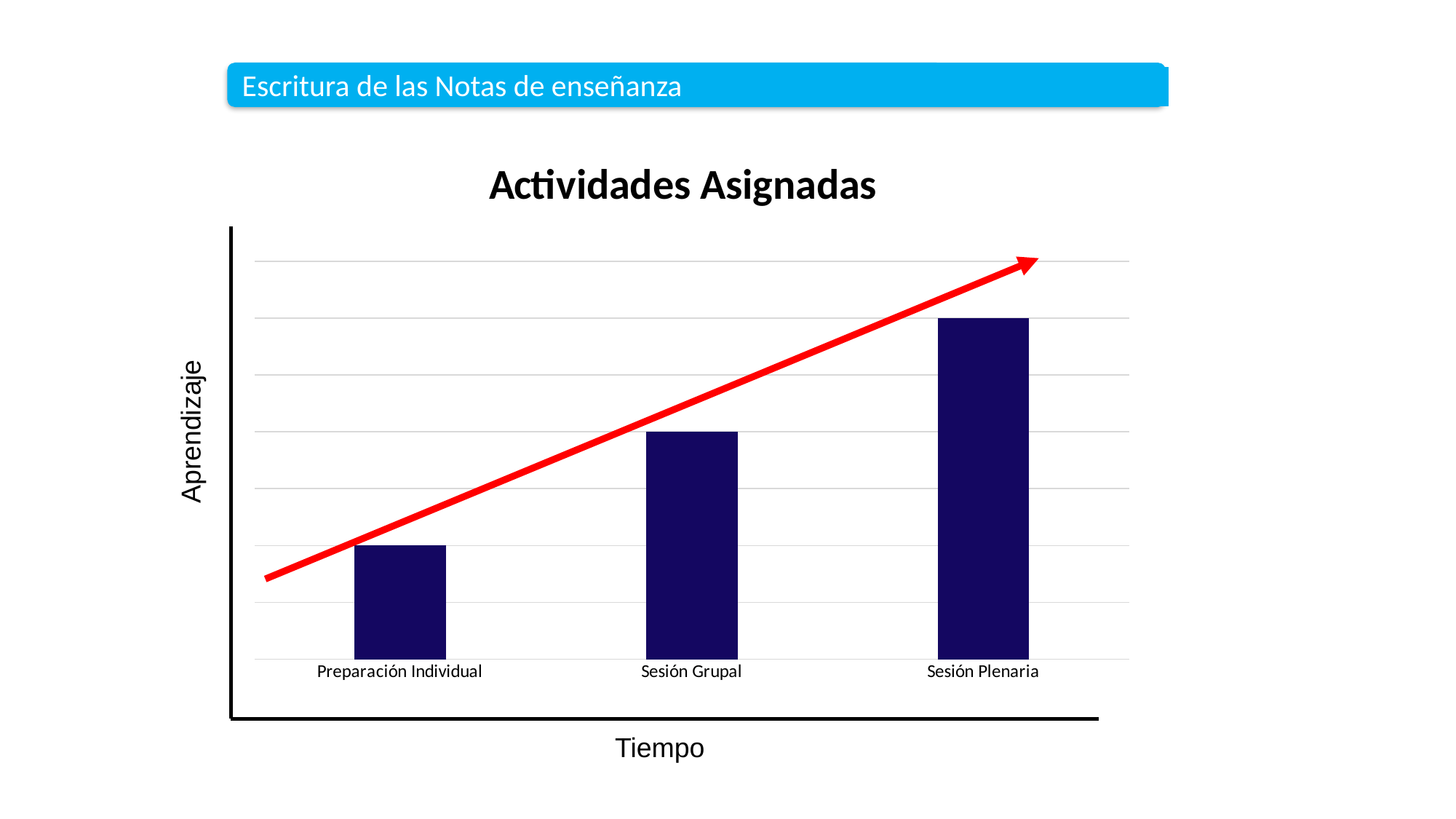
Which is larger, the bar for Sesión Plenaria or the bar for Sesión Grupal? Sesión Plenaria Which category has the highest bar in the chart? Sesión Plenaria Do the bar values rise or fall from left to right along the x axis? Rise What is the title of the chart? Actividades Asignadas How many categories are shown on the x axis of the chart? 3 Which category has the lowest bar in the chart? Preparación Individual What kind of chart is shown on the slide? Bar chart What is the label of the vertical axis of the chart? Aprendizaje What is the label of the horizontal axis of the chart? Tiempo Which is larger, the bar for Sesión Grupal or the bar for Preparación Individual? Sesión Grupal